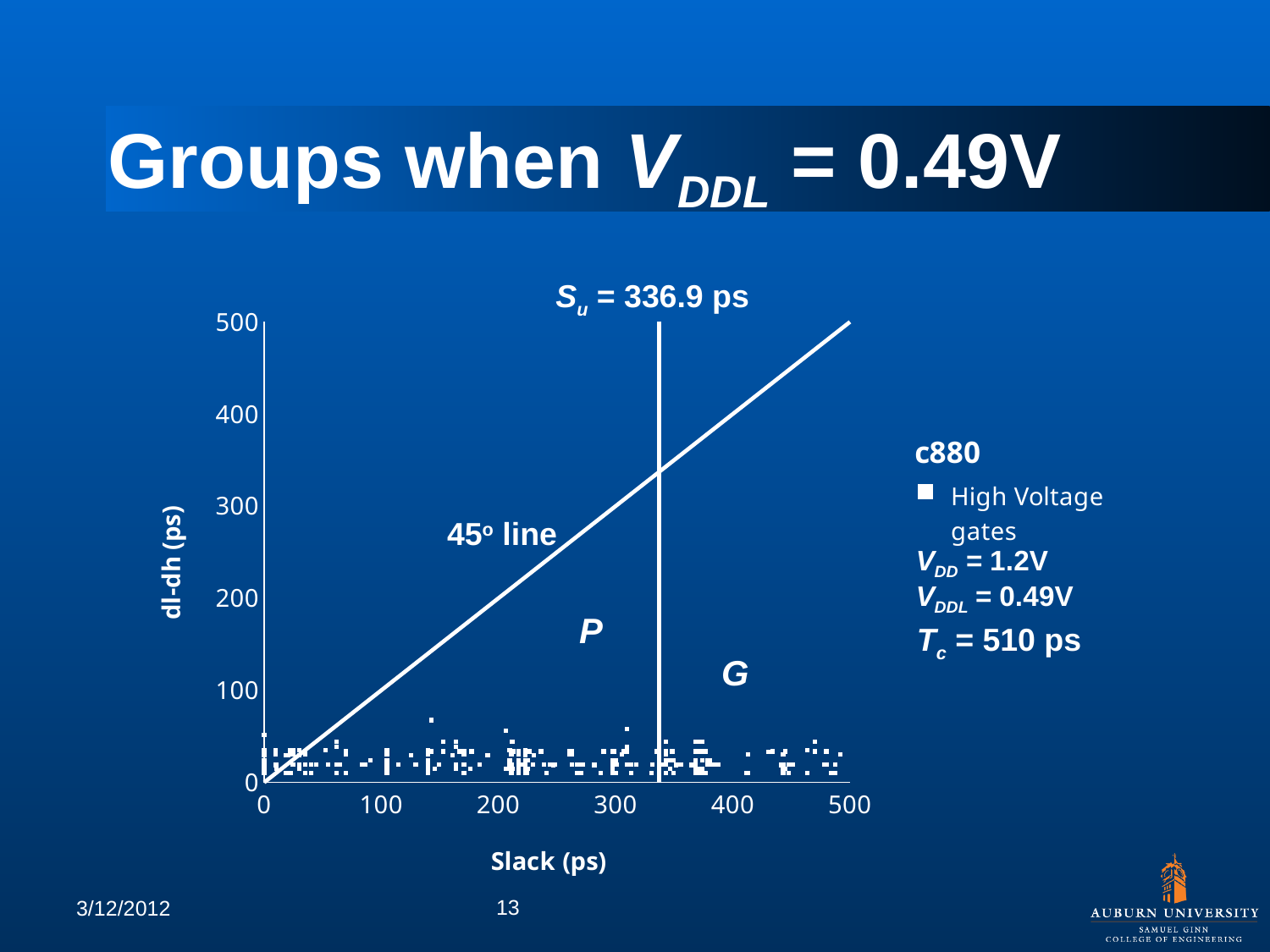
What is the label of the x axis? Slack (ps) What is the highest tick value shown on the x axis (Slack)? 500 What is the highest tick value shown on the y axis (dl-dh)? 500 What kind of chart is shown on the slide? scatter plot Is the vertical S_u line positioned at a slack greater or less than 300 ps? greater How many series does the chart legend list? 1 What is the value of S_u marked by the vertical line on the chart? 336.9 ps Are the plotted High Voltage gate points on the dl-dh axis greater or less than 100 ps? less What is the value of T_c stated next to the chart? 510 ps Which circuit name is given above the legend? c880 What is the series name shown in the chart legend? High Voltage gates What is the value of V_DD stated next to the chart? 1.2V